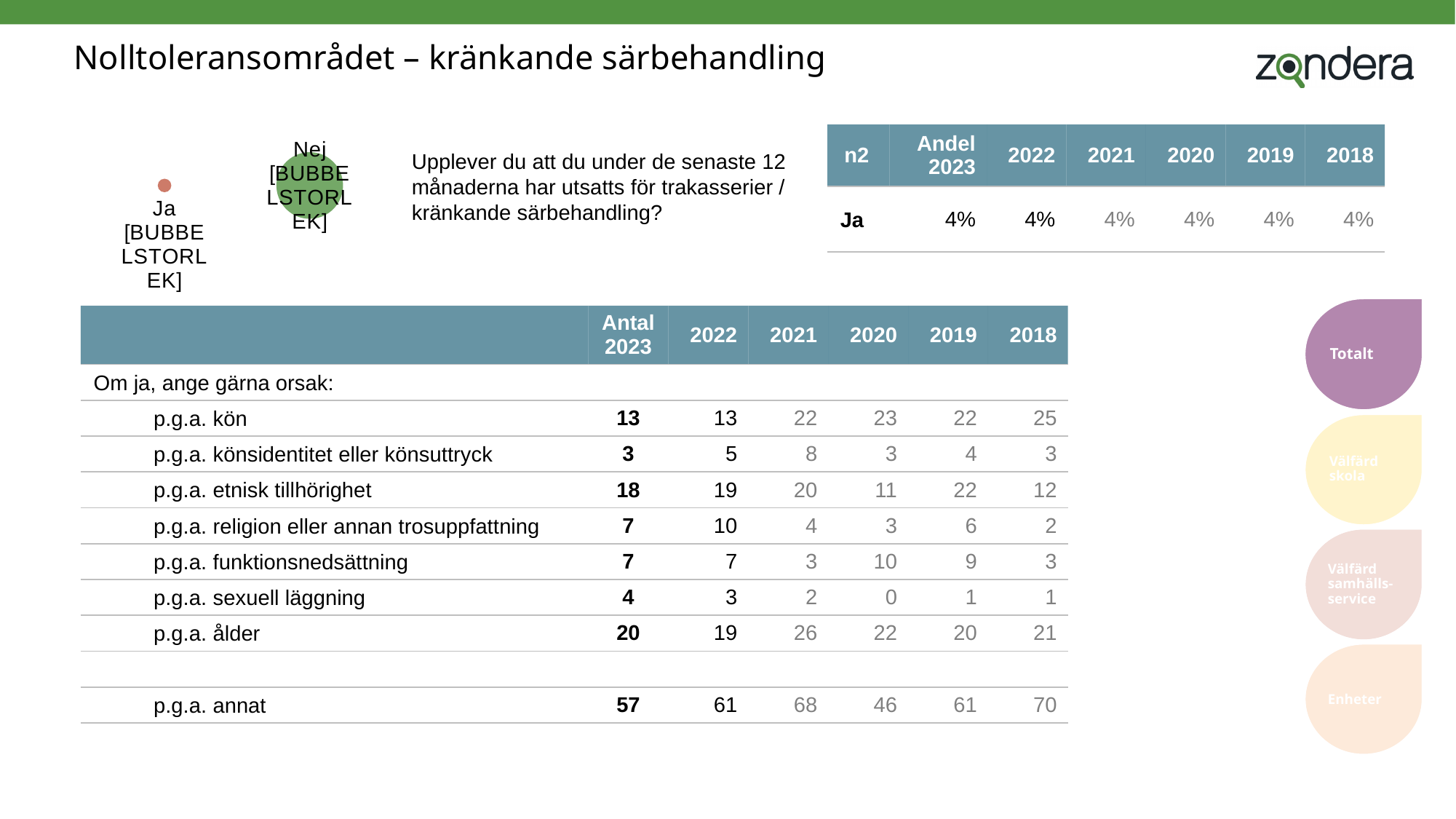
Which category has the largest bubble in the bubble chart? Nej Which category has the smallest bubble in the bubble chart? Ja Which bubble is larger in the bubble chart, Ja or Nej? Nej What are the labels of the two bubbles in the bubble chart? Ja and Nej What colour is the Nej bubble in the bubble chart? Green How many bubbles (categories) does the bubble chart show? 2 What kind of chart is shown on the left of the slide? Bubble chart